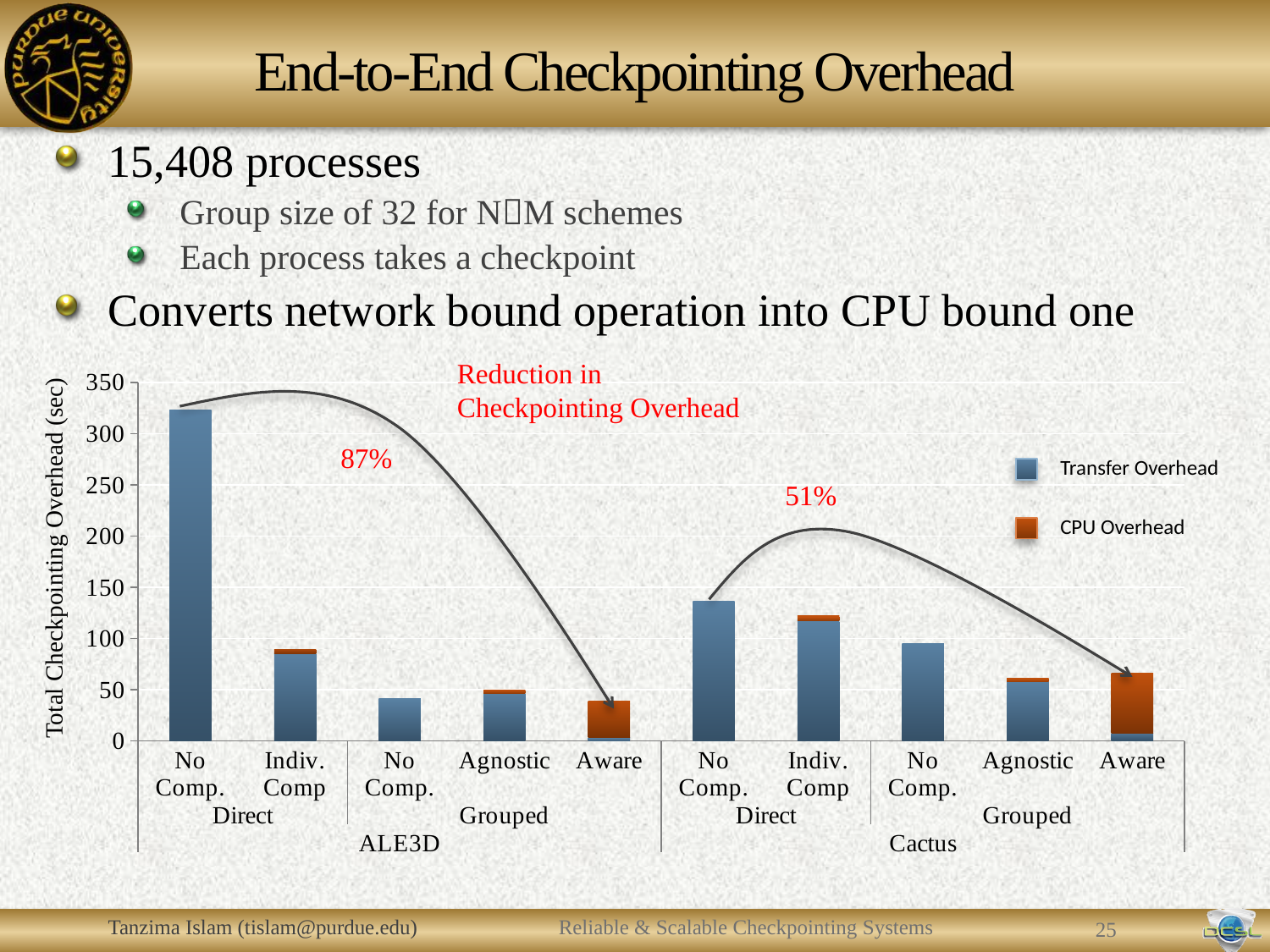
How many series does the chart legend list? 2 Is the total for ALE3D Grouped No Comp. greater or less than 50? less Is the total for ALE3D Direct No Comp. greater or less than 300? greater Which bar has the highest total checkpointing overhead? ALE3D Direct No Comp. Which is larger, the total for ALE3D Direct No Comp. or Cactus Direct No Comp.? ALE3D Direct No Comp. What reduction in checkpointing overhead is annotated for ALE3D? 87% What kind of chart is shown on the slide? Stacked bar chart Is the total for ALE3D Direct Indiv. Comp greater or less than 100? less How many bars are plotted in the chart? 10 What are the two series named in the chart legend? Transfer Overhead and CPU Overhead Which is larger, the total for Cactus Direct No Comp. or Cactus Grouped Agnostic? Cactus Direct No Comp.